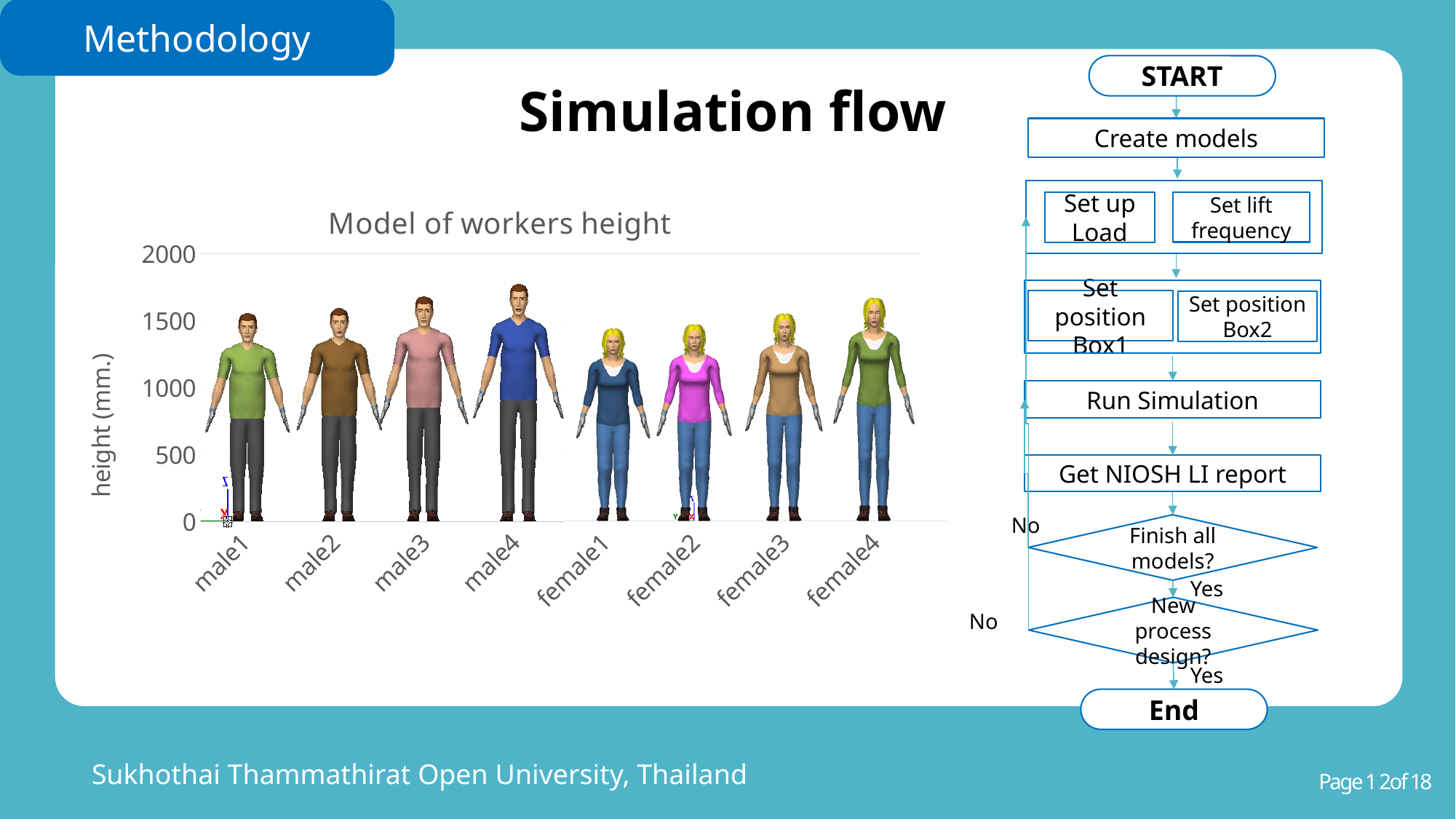
Is the height for male4 greater or less than 1500? greater What is the highest value shown on the vertical axis of the chart? 2000 Is the height for male1 greater or less than 1000? greater What is the label of the vertical axis of the chart? height (mm.) Is the height for male4 greater or less than 2000? less How many worker models (categories) are shown along the x axis of the chart? 8 What is the title of the chart on the slide? Model of workers height Which is taller in the chart, male4 or male1? male4 Which worker model has the greatest height in the chart? male4 Which is taller in the chart, male4 or female1? male4